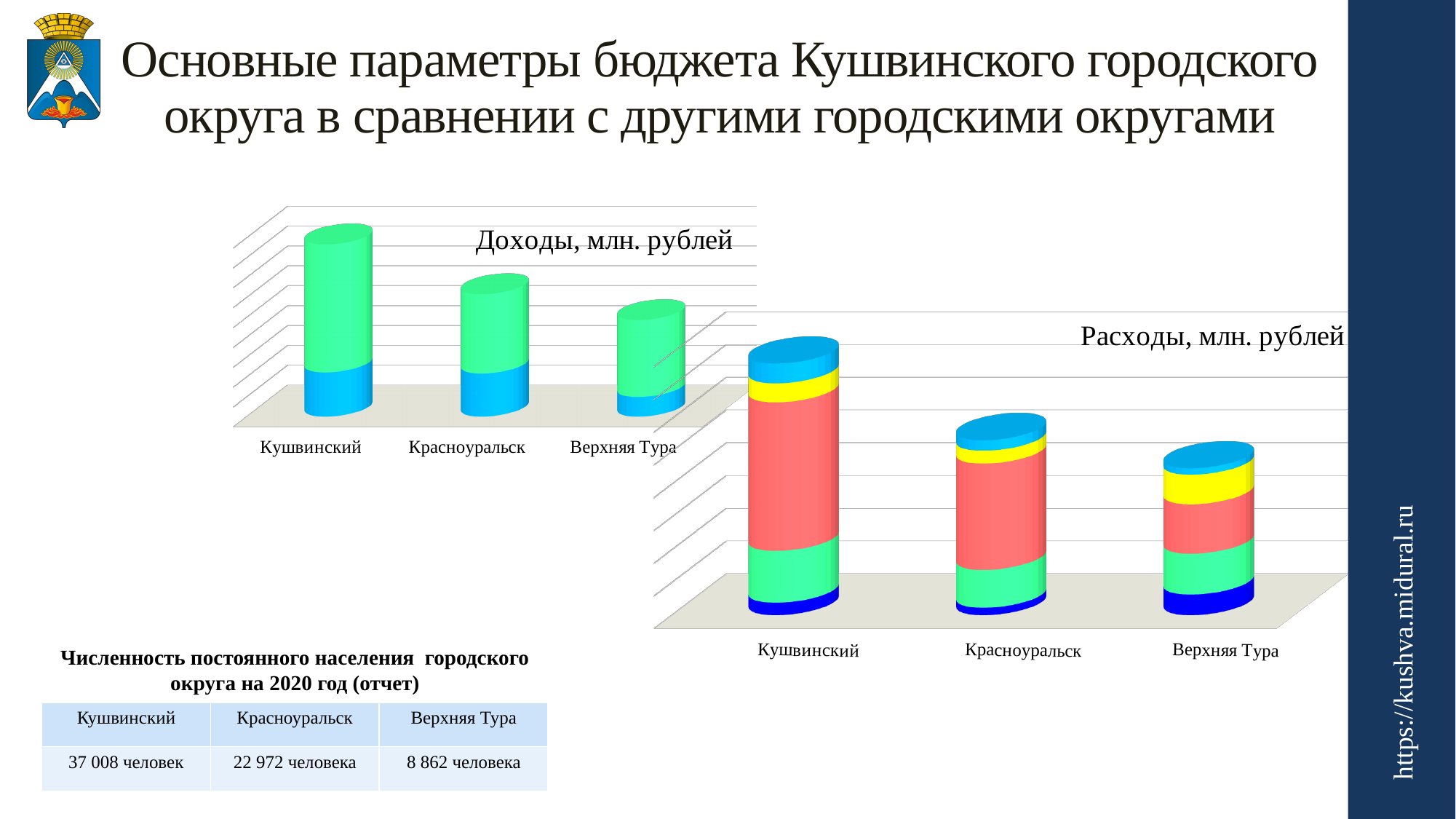
What is the title of the chart on the right side of the slide? Расходы, млн. рублей In the chart titled "Расходы, млн. рублей", which city district has the highest total bar? Кушвинский In the chart titled "Доходы, млн. рублей", do the total bar heights rise or fall from left to right? fall In the chart titled "Расходы, млн. рублей", which city district has the lowest total bar? Верхняя Тура In the chart titled "Доходы, млн. рублей", how many city districts are shown on the x axis? 3 In the chart titled "Доходы, млн. рублей", which city district has the lowest total bar? Верхняя Тура In the chart titled "Расходы, млн. рублей", how many city districts are shown on the x axis? 3 In the chart titled "Расходы, млн. рублей", do the total bar heights rise or fall from left to right? fall In the chart titled "Доходы, млн. рублей", which is larger, the total for Красноуральск or for Верхняя Тура? Красноуральск In the chart titled "Доходы, млн. рублей", which city district has the highest total bar? Кушвинский What kind of chart is the one titled "Доходы, млн. рублей"? bar chart In the chart titled "Расходы, млн. рублей", which is larger, the total for Кушвинский or for Красноуральск? Кушвинский